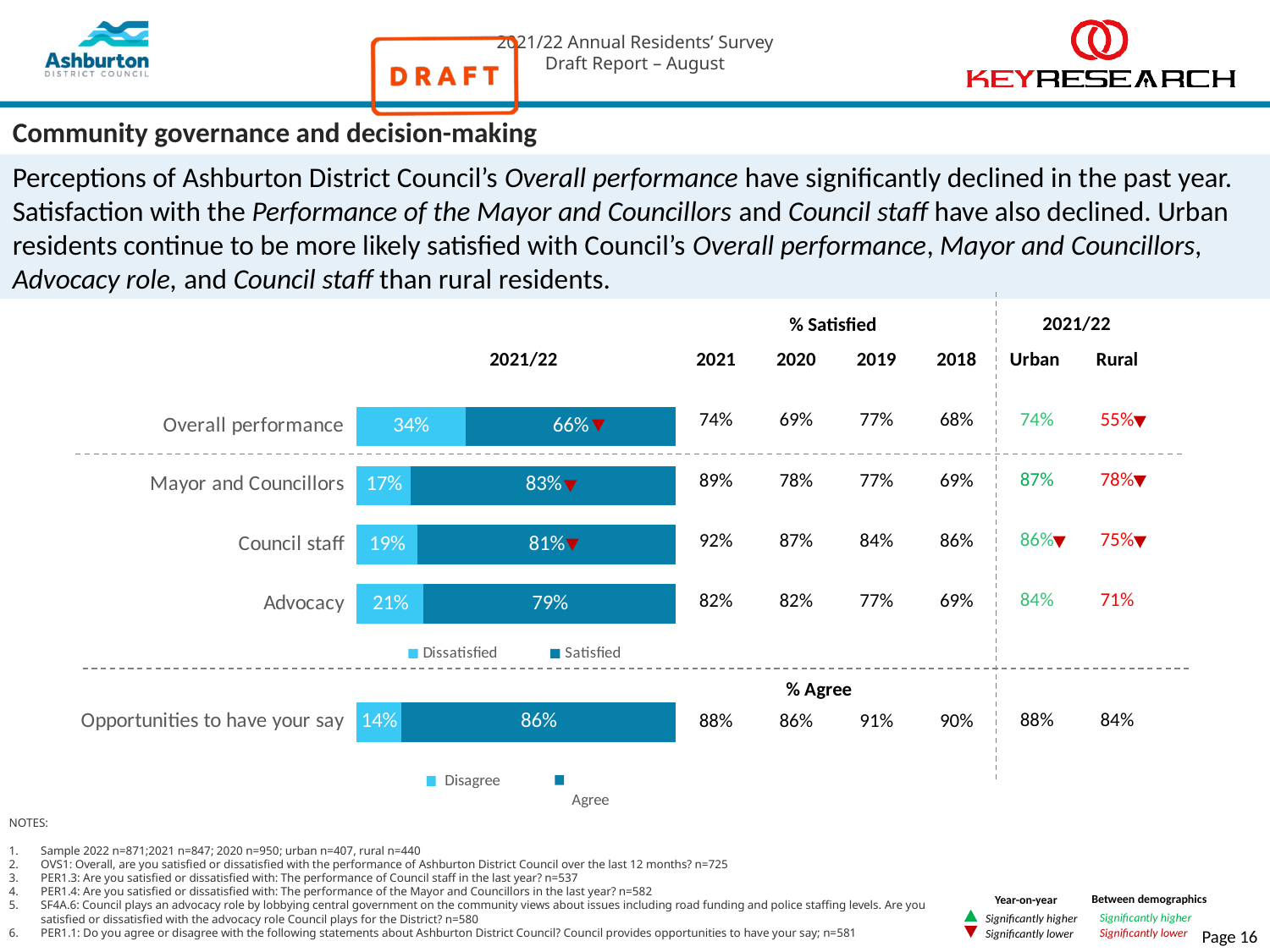
What type of chart is used for Opportunities to have your say at the bottom of the slide? Stacked bar chart In the upper stacked bar chart, which category has the lowest Satisfied value? Overall performance In the upper stacked bar chart, what is the Dissatisfied value for Mayor and Councillors? 17% In the upper stacked bar chart (Dissatisfied/Satisfied), what is the Satisfied value for Overall performance? 66% In the upper stacked bar chart, what is the Dissatisfied value for Advocacy? 21% How many series does the legend of the upper chart list? 2 In the upper stacked bar chart, what is the Satisfied value for Council staff? 81% In the upper stacked bar chart, what is the difference between the Satisfied values for Mayor and Councillors and Overall performance? 17% In the upper stacked bar chart, which is larger: the Dissatisfied value for Council staff or for Advocacy? Advocacy In the lower stacked bar chart (Disagree/Agree), what is the Agree value for Opportunities to have your say? 86% In the upper stacked bar chart, which category has the highest Satisfied value? Mayor and Councillors How many categories are plotted in the upper stacked bar chart? 4